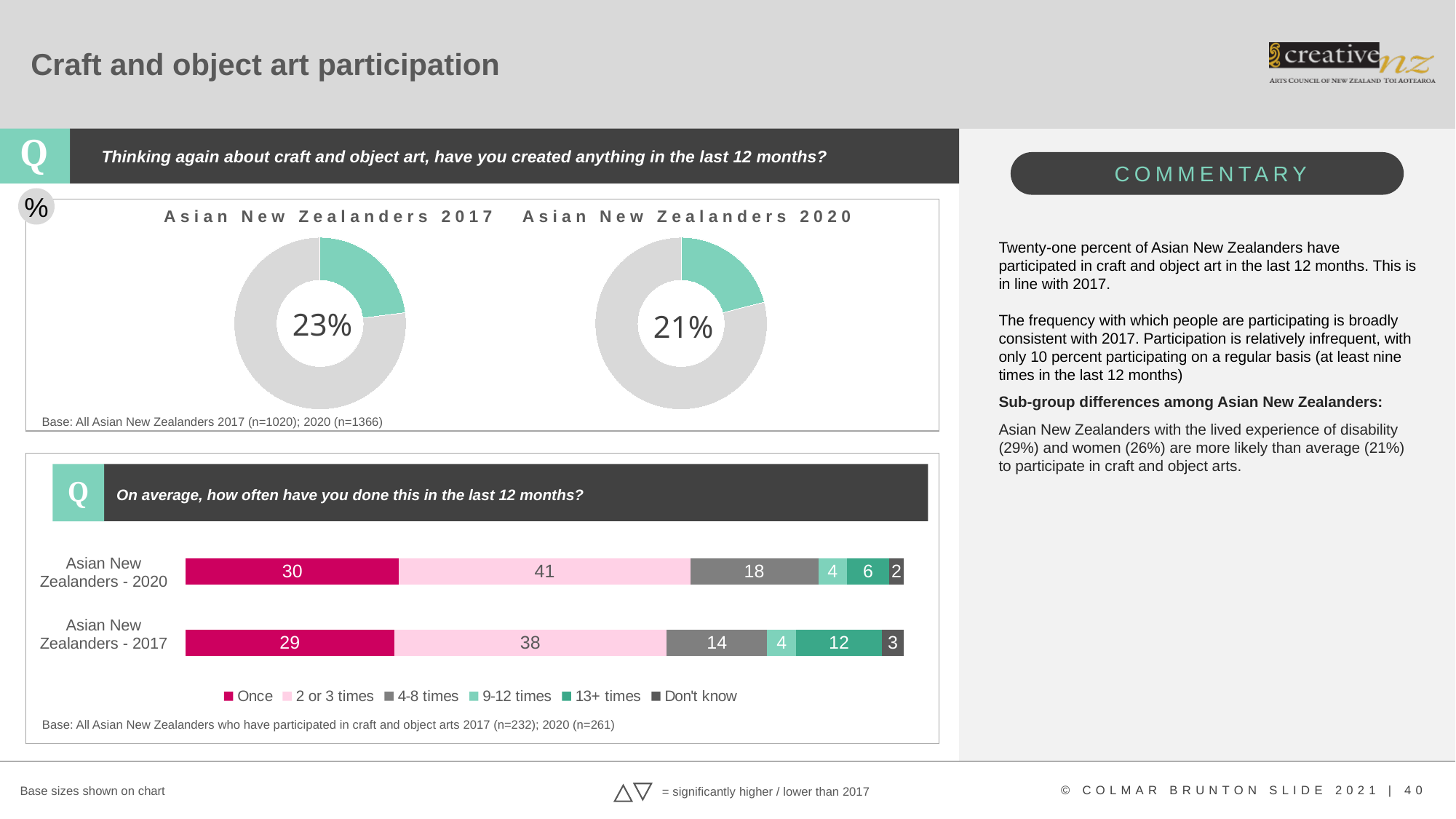
In the stacked bar chart, what is the difference between the '13+ times' value for 2017 and for 2020? 6 In the stacked bar chart, what is the value for '2 or 3 times' for Asian New Zealanders - 2017? 38 Comparing the two donut charts, which year shows the higher participation percentage, 2017 or 2020? 2017 In the stacked bar chart, how many series does the legend list? 6 In the stacked bar chart on how often people have done this, what is the value for 'Once' for Asian New Zealanders - 2020? 30 What is the difference in percentage points between the 2017 donut value and the 2020 donut value? 2 In the donut chart titled 'Asian New Zealanders 2020', what percentage is shown in the centre? 21% In the stacked bar chart, which frequency segment has the largest value for Asian New Zealanders - 2020? 2 or 3 times In the donut chart titled 'Asian New Zealanders 2017', what percentage is shown in the centre? 23% In the stacked bar chart, how many bars (categories) are shown? 2 In the stacked bar chart, what is the value for '13+ times' for Asian New Zealanders - 2017? 12 What kind of chart is used for the 'how often have you done this' question? Stacked bar chart